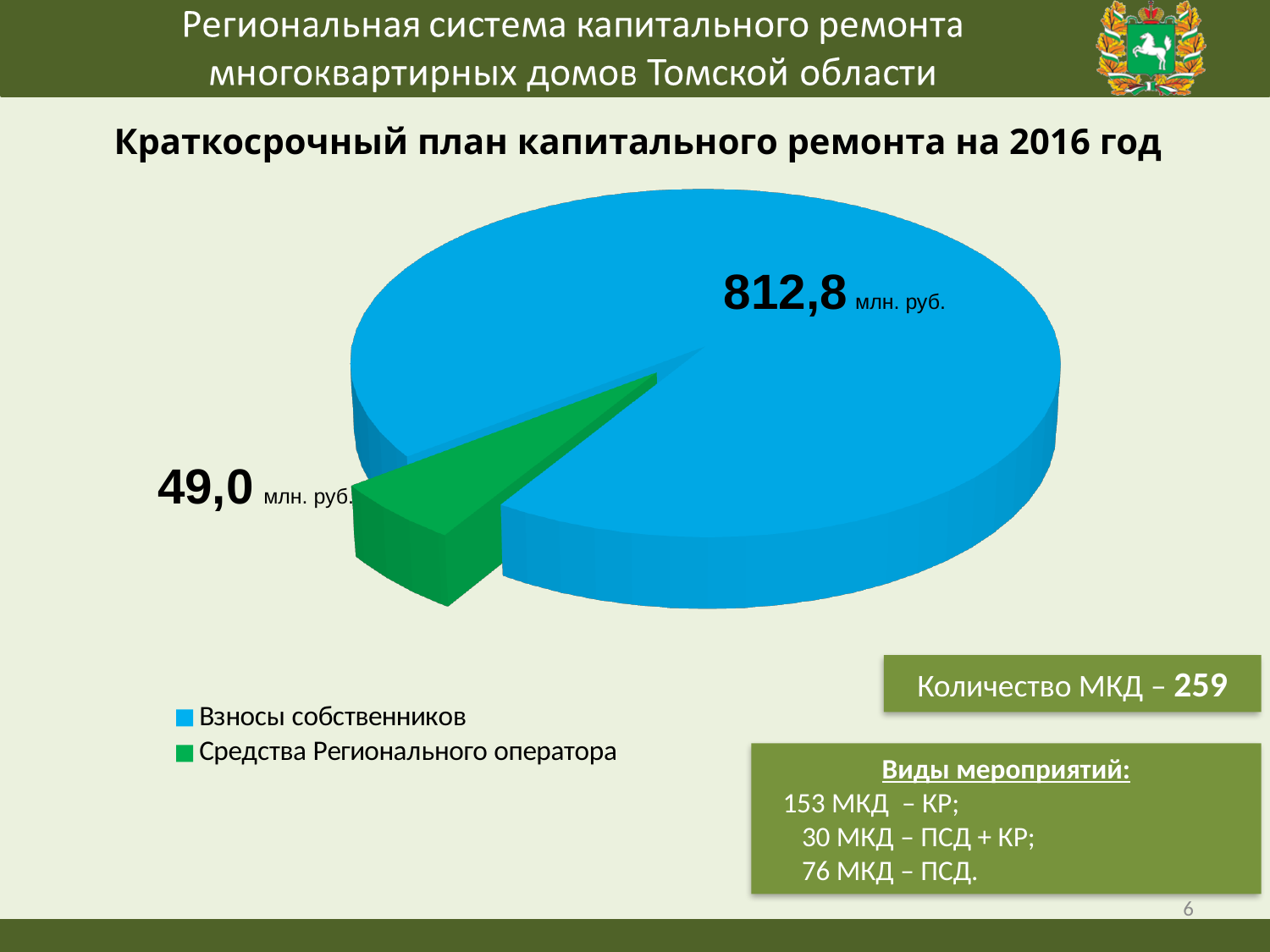
Which category has the smallest slice of the pie? Средства Регионального оператора What colour is the slice for Средства Регионального оператора? Green Which category has the largest slice of the pie? Взносы собственников What kind of chart is shown on the slide? Pie chart What is the difference between Взносы собственников and Средства Регионального оператора? 763,8 млн. руб. What is the value for Взносы собственников? 812,8 млн. руб. What is the value for Средства Регионального оператора? 49,0 млн. руб. How many slices does the pie chart have? 2 What is the title above the chart? Краткосрочный план капитального ремонта на 2016 год How many entries does the legend list? 2 Which is larger: Взносы собственников or Средства Регионального оператора? Взносы собственников What is the total of the two slices in the pie chart? 861,8 млн. руб.